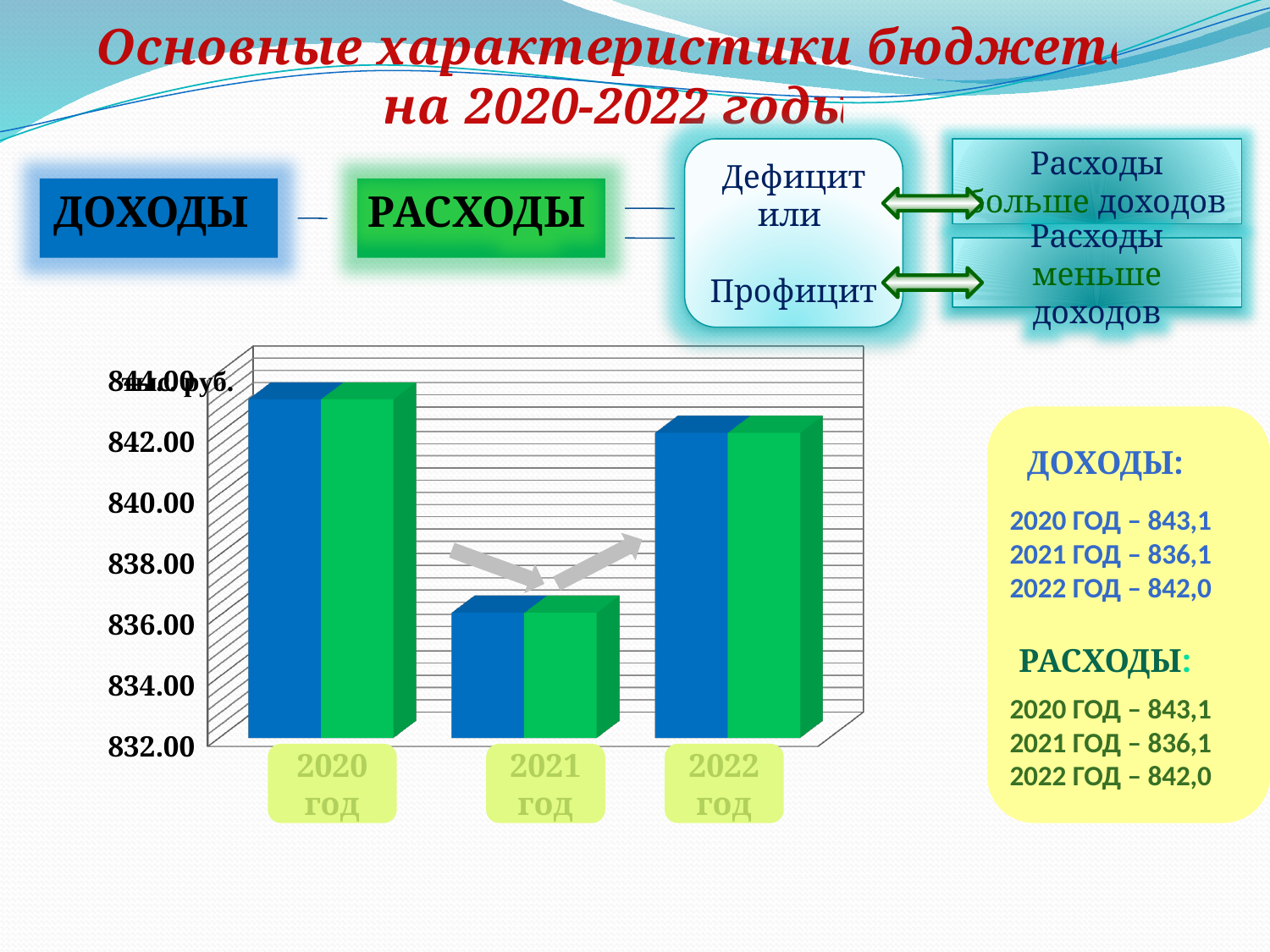
Is the value of the green bar for 2022 год greater or less than 840.00? greater Which is larger, the blue bar for 2020 год or the blue bar for 2022 год? 2020 год Which year has the lowest bars in the chart? 2021 год How many bars are plotted for each year in the chart? 2 According to the text box on the slide, what is the ДОХОДЫ value for 2021 год? 836,1 Which year has the highest bars in the chart? 2020 год Do the bar values rise or fall from 2020 год to 2021 год? fall Is the value of the blue bar for 2021 год greater or less than 838.00? less What kind of chart is shown on the slide? bar chart How many year categories are shown on the x axis of the chart? 3 Is the value of the blue bar for 2020 год greater or less than 842.00? greater What is the lowest value shown on the vertical axis of the chart? 832.00